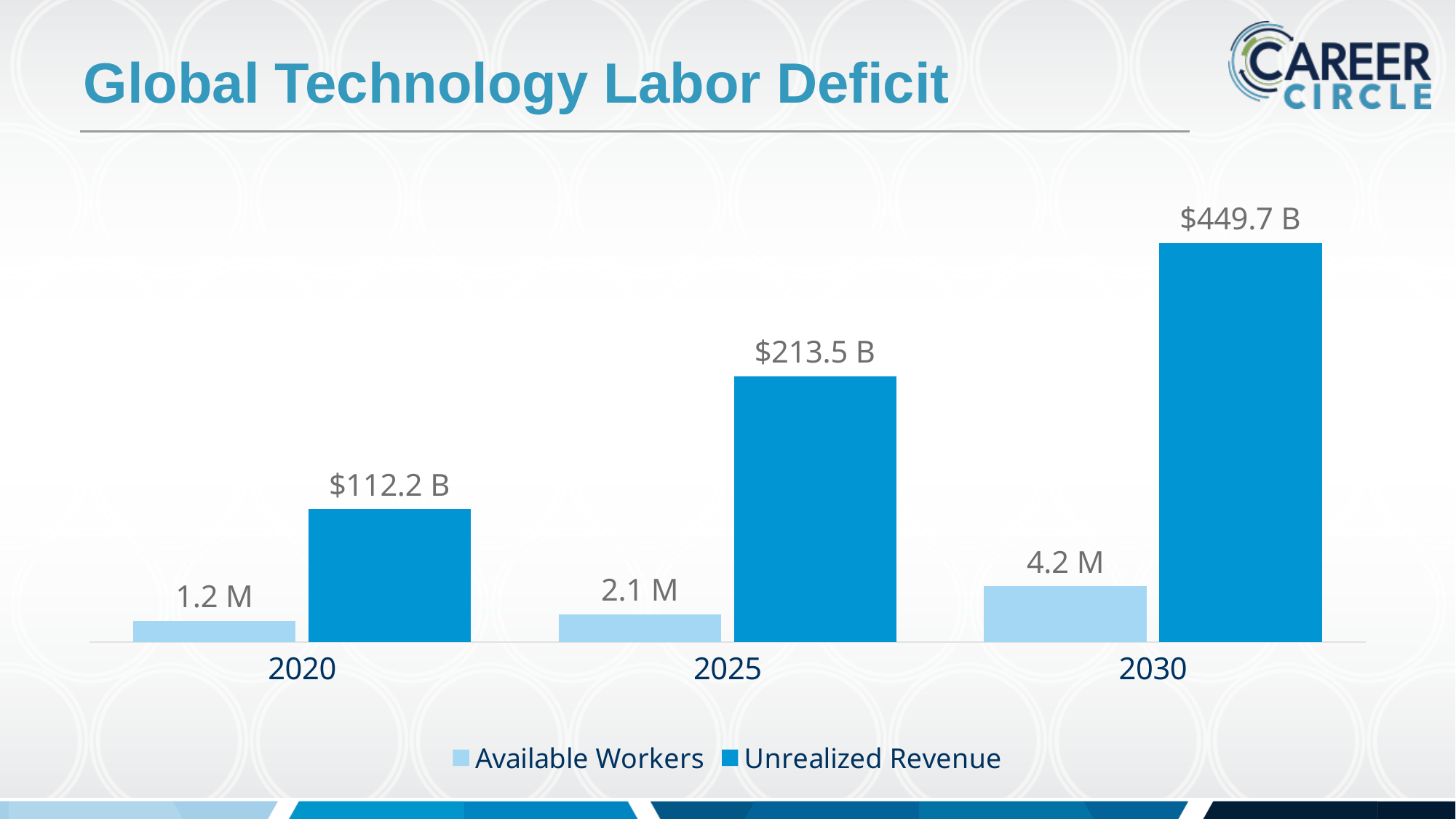
What is the difference in Unrealized Revenue between 2030 and 2025? $236.2 B What kind of chart is shown on the slide? Bar chart What is the Unrealized Revenue value for 2025? $213.5 B What is the Available Workers value for 2020? 1.2 M What is the difference in Available Workers between 2030 and 2020? 3.0 M What is the Unrealized Revenue value for 2030? $449.7 B Which year has the highest Unrealized Revenue? 2030 Which year has the lowest Available Workers value? 2020 What is the Available Workers value for 2030? 4.2 M Which is larger, the Unrealized Revenue for 2020 or for 2025? 2025 How many series does the legend list? 2 How many years are shown on the x axis? 3